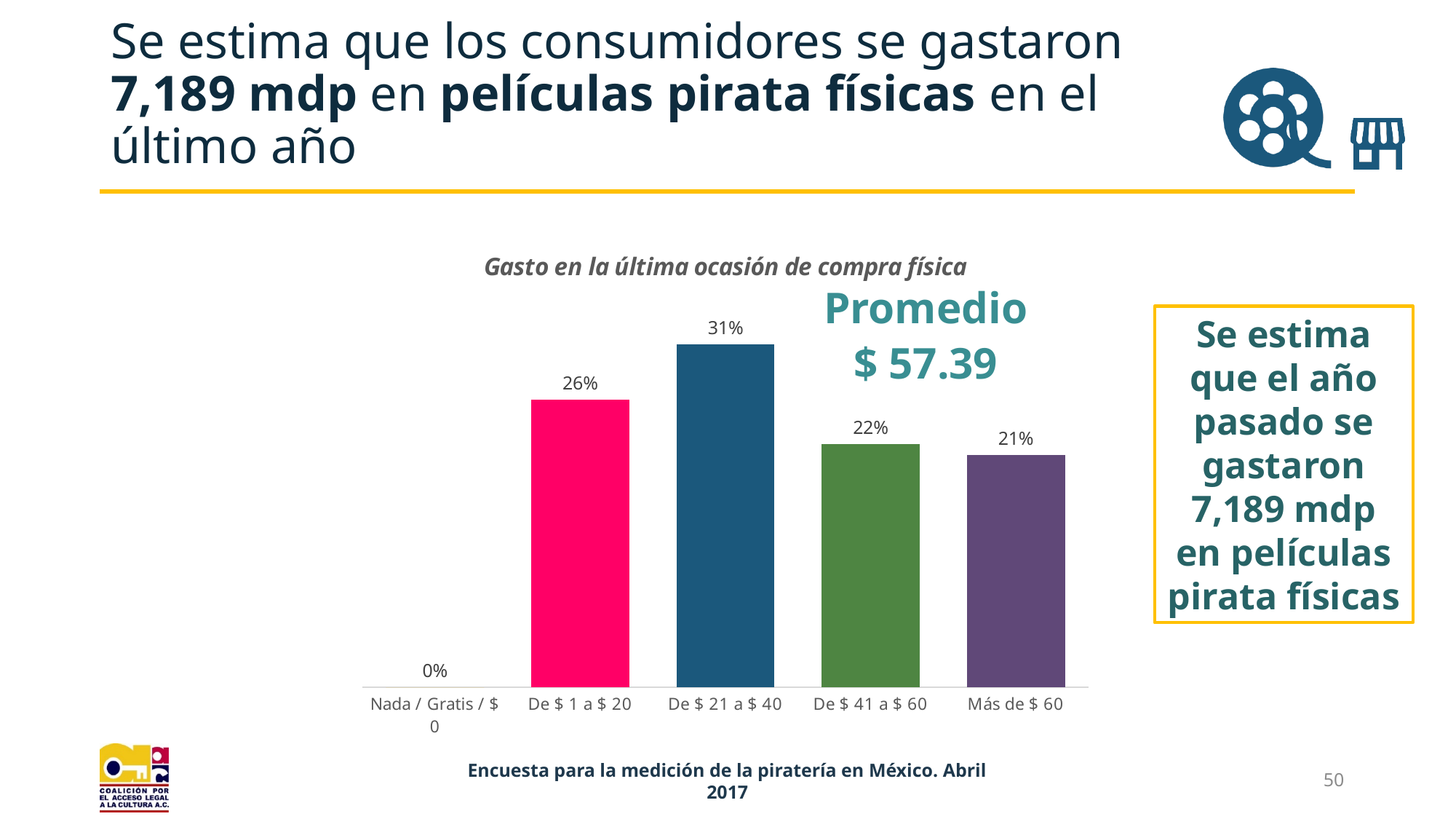
What is the value for the 'De $ 21 a $ 40' category? 31% What average (Promedio) value is shown next to the chart? $ 57.39 What is the value for the 'Nada / Gratis / $ 0' category? 0% Which category has the lowest value? Nada / Gratis / $ 0 What is the value for the 'Más de $ 60' category? 21% What is the difference between the values for 'De $ 21 a $ 40' and 'De $ 41 a $ 60'? 9% What is the title of the chart? Gasto en la última ocasión de compra física Which is larger, the value for 'De $ 1 a $ 20' or the value for 'Más de $ 60'? De $ 1 a $ 20 Which category has the highest value? De $ 21 a $ 40 What kind of chart is shown on the slide? Bar chart What is the value for the 'De $ 1 a $ 20' category? 26% How many categories are shown on the x axis of the chart? 5